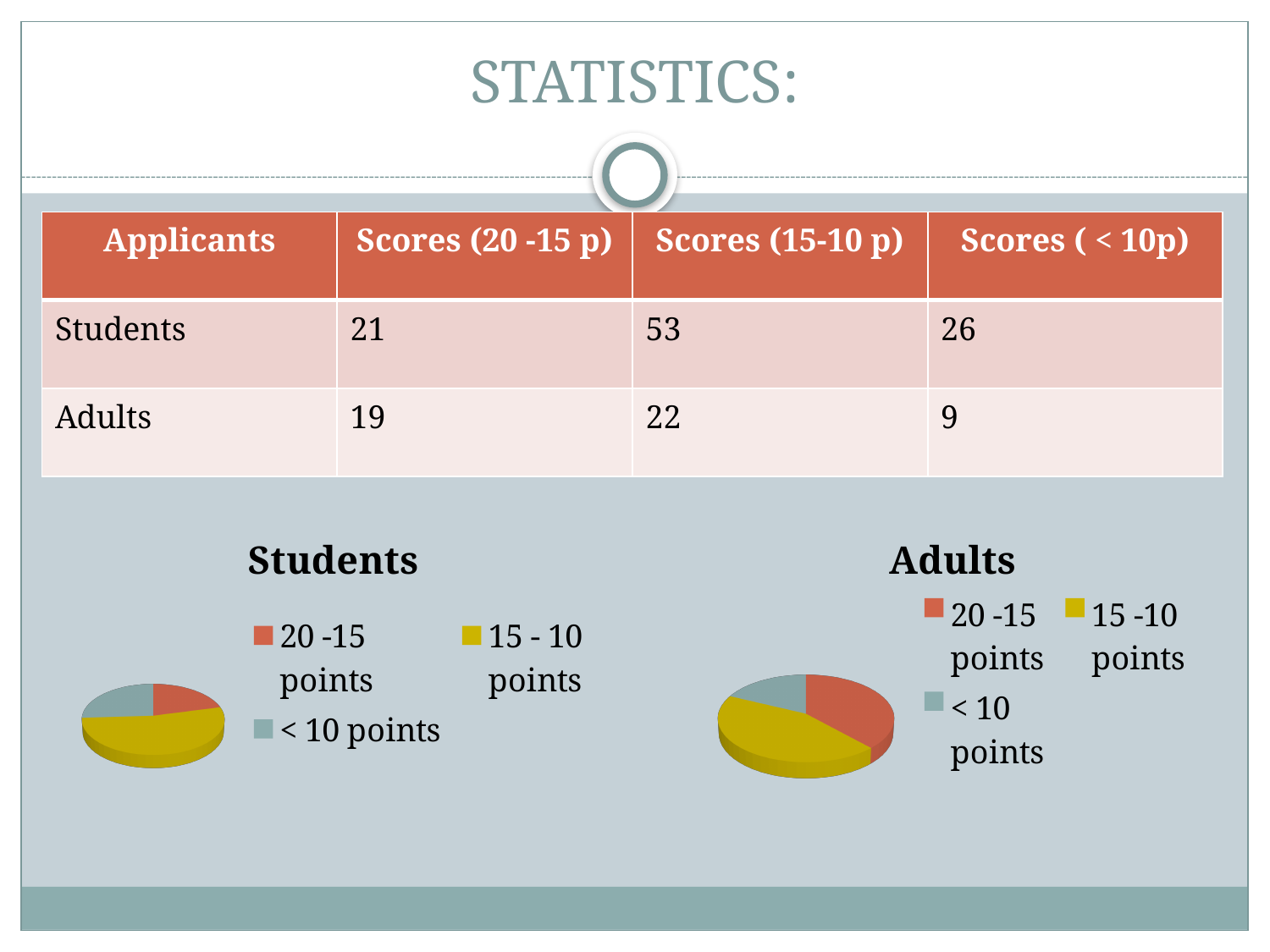
In the Students pie chart, which score category has the largest slice? 15 - 10 points According to the table, how many students scored 15-10 points? 53 How many slices does the Students pie chart have? 3 How many entries does the legend of the Adults pie chart list? 3 In the Students pie chart, is the slice for 15 - 10 points larger or smaller than the slice for < 10 points? larger What kind of chart is the Adults chart? pie chart According to the table, how many adults scored less than 10 points? 9 Which colour represents the 20 -15 points category in the Students pie chart? red What kind of chart is the Students chart? pie chart In the Adults pie chart, which score category has the largest slice? 15 -10 points In the Adults pie chart, which score category has the smallest slice? < 10 points Using the table values, what is the difference between the number of students scoring 15-10 points and those scoring less than 10 points? 27